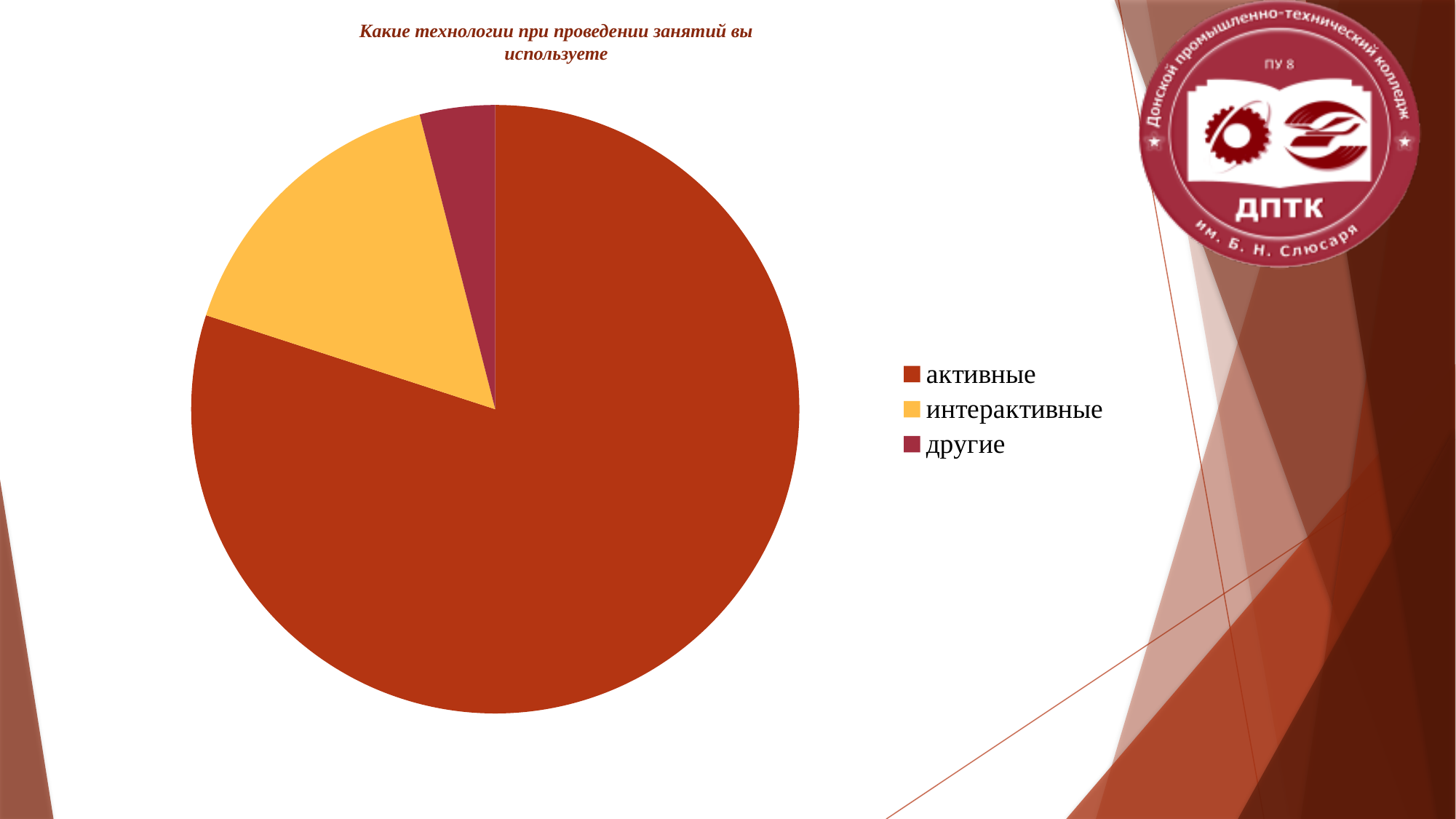
Which category has the largest slice of the pie? активные Which slice is larger, активные or интерактивные? активные Which slice is larger, интерактивные or другие? интерактивные What is the title of the chart? Какие технологии при проведении занятий вы используете Which category is shown in yellow in the legend? интерактивные How many entries does the legend list? 3 How many categories (slices) does the pie chart have? 3 What kind of chart is shown on the slide? pie chart Which category has the smallest slice of the pie? другие Does the активные slice take up more or less than half of the pie? more